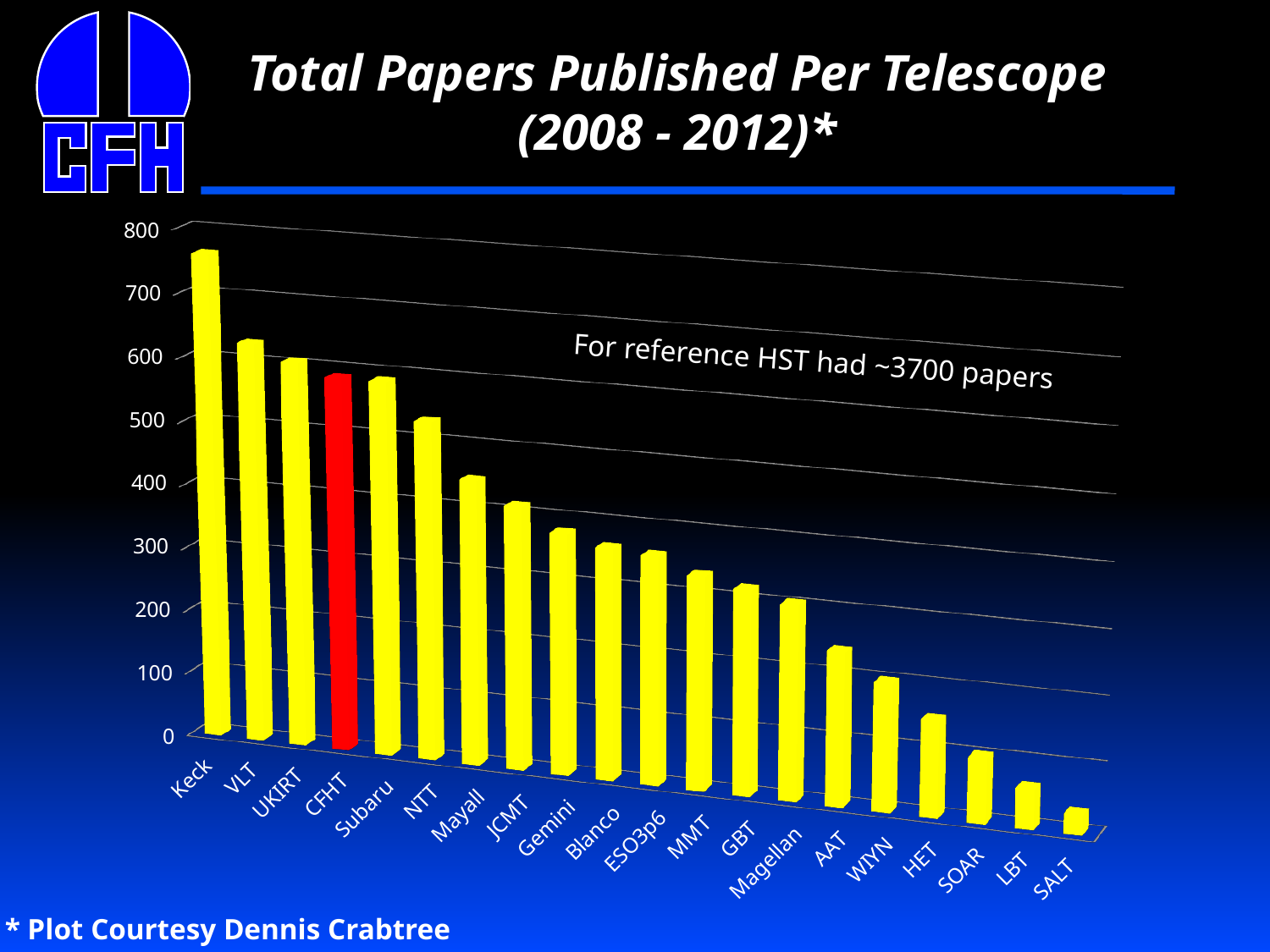
Which telescope's bar is coloured red? CFHT How many telescopes are shown on the x axis? 20 Is the value for SALT greater or less than 100? less Do the values rise or fall moving from left to right along the x axis? fall Which telescope has the lowest number of papers published? SALT Is the value for CFHT greater or less than 500? greater Which telescope has the highest number of papers published? Keck Is the value for Gemini greater or less than 400? less What kind of chart is shown on the slide? bar chart Which has more papers published, Keck or VLT? Keck